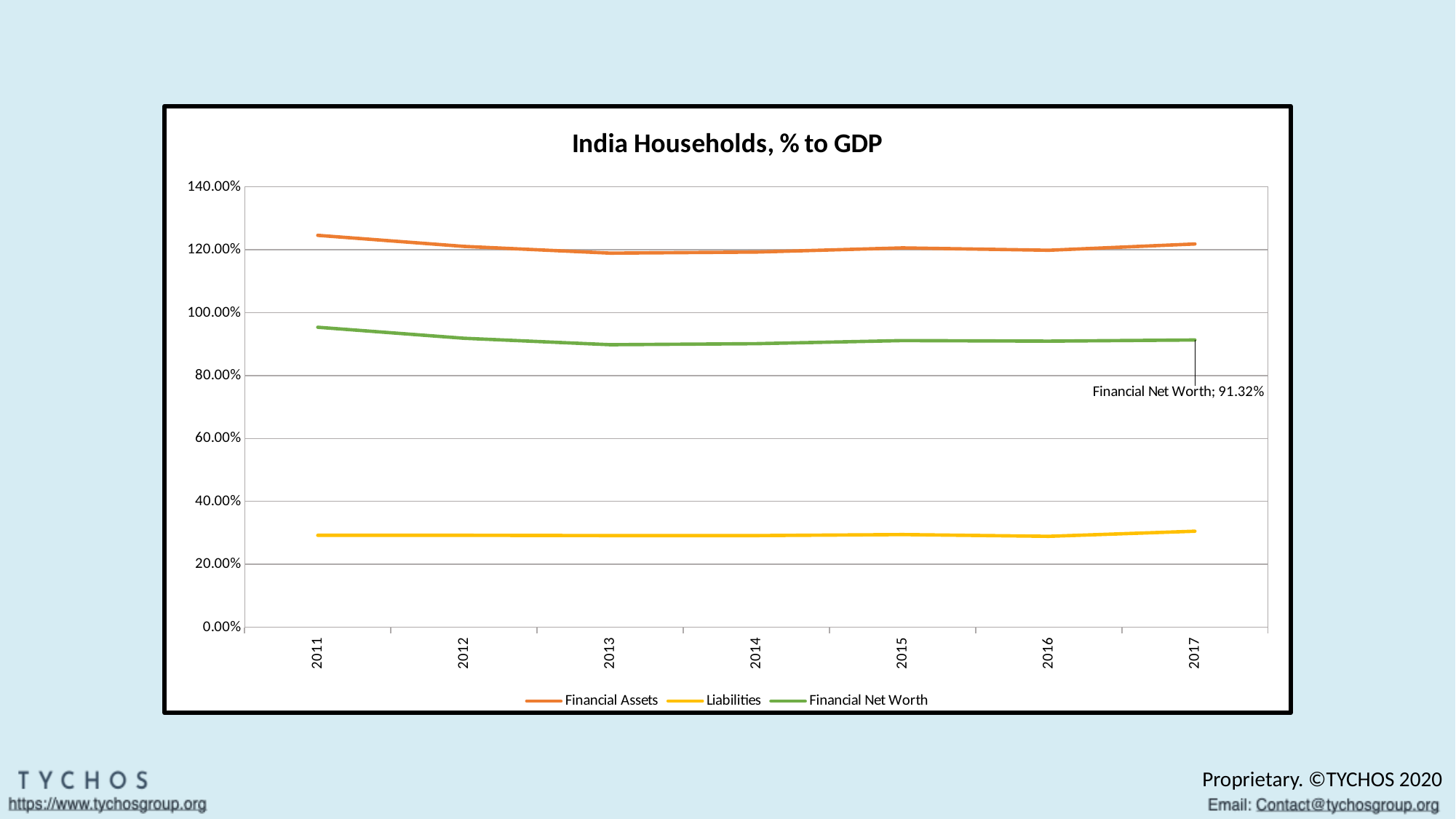
Which is larger in 2015, Financial Assets or Financial Net Worth? Financial Assets What is the title of the chart? India Households, % to GDP What is the value of Financial Net Worth in 2017? 91.32% Does the Financial Net Worth line rise or fall from 2011 to 2013? fall Which series has the highest values across all years? Financial Assets Is the value for Liabilities in 2017 greater or less than 40.00%? less Is the value for Financial Net Worth in 2013 greater or less than 100.00%? less Is the value for Financial Assets in 2011 greater or less than 120.00%? greater What kind of chart is shown on the slide? line chart Which series has the lowest values across all years? Liabilities How many series does the legend list? 3 How many years are shown on the x axis? 7